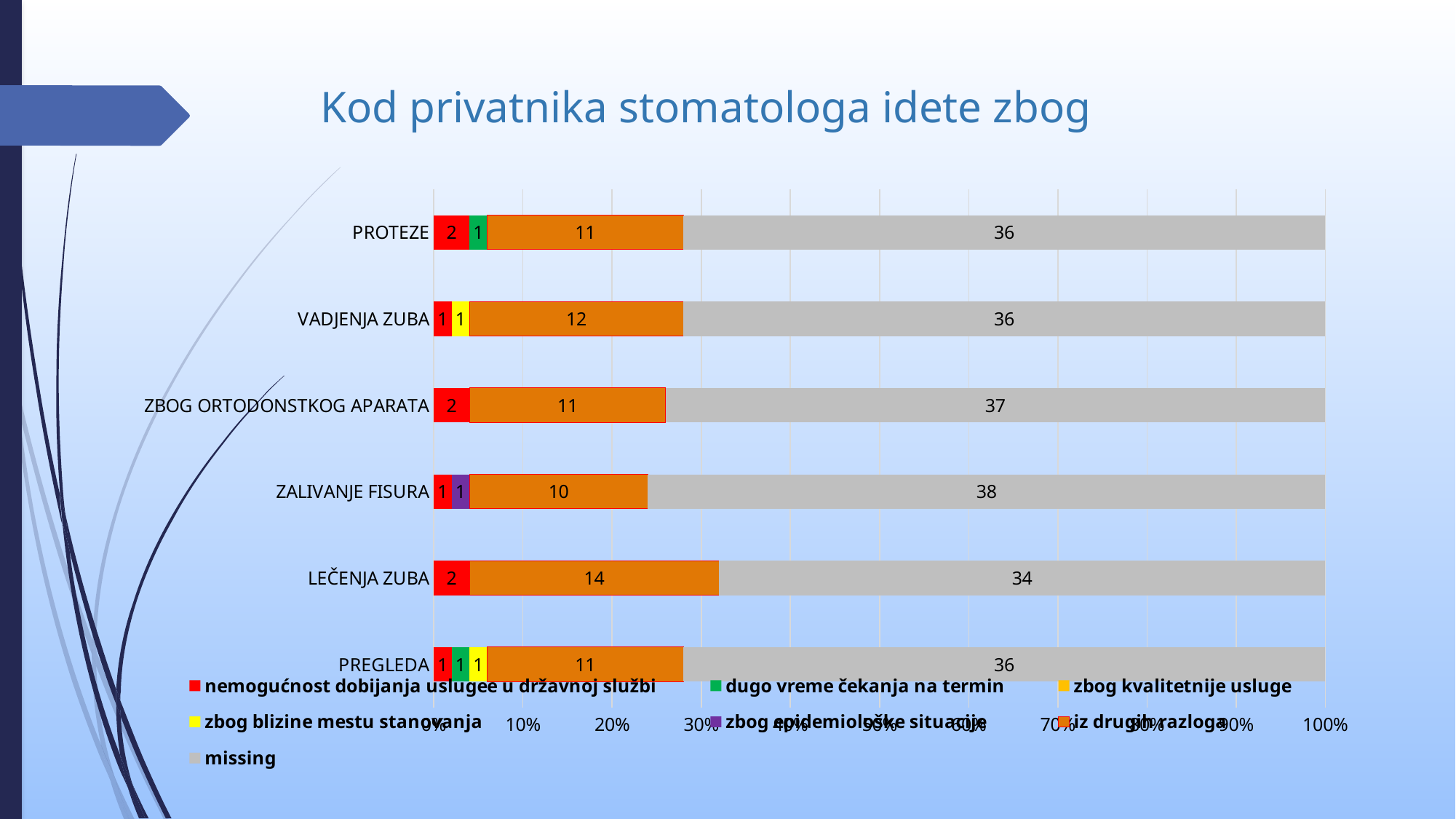
Which has the larger 'missing' value, VADJENJA ZUBA or ZBOG ORTODONSTKOG APARATA? ZBOG ORTODONSTKOG APARATA How many series does the legend list? 7 Which category has the lowest 'missing' value? LEČENJA ZUBA What kind of chart is shown on the slide? Stacked bar chart What is the 'missing' value for LEČENJA ZUBA? 34 How many categories are plotted on the chart? 6 What is the difference between the 'missing' values for PROTEZE and LEČENJA ZUBA? 2 Which category has the highest 'missing' value? ZALIVANJE FISURA What is the total of all segments in the PROTEZE bar? 50 What is the value of 'nemogućnost dobijanja uslugee u državnoj službi' for LEČENJA ZUBA? 2 What is the title of the slide? Kod privatnika stomatologa idete zbog What is the 'missing' value for ZALIVANJE FISURA? 38